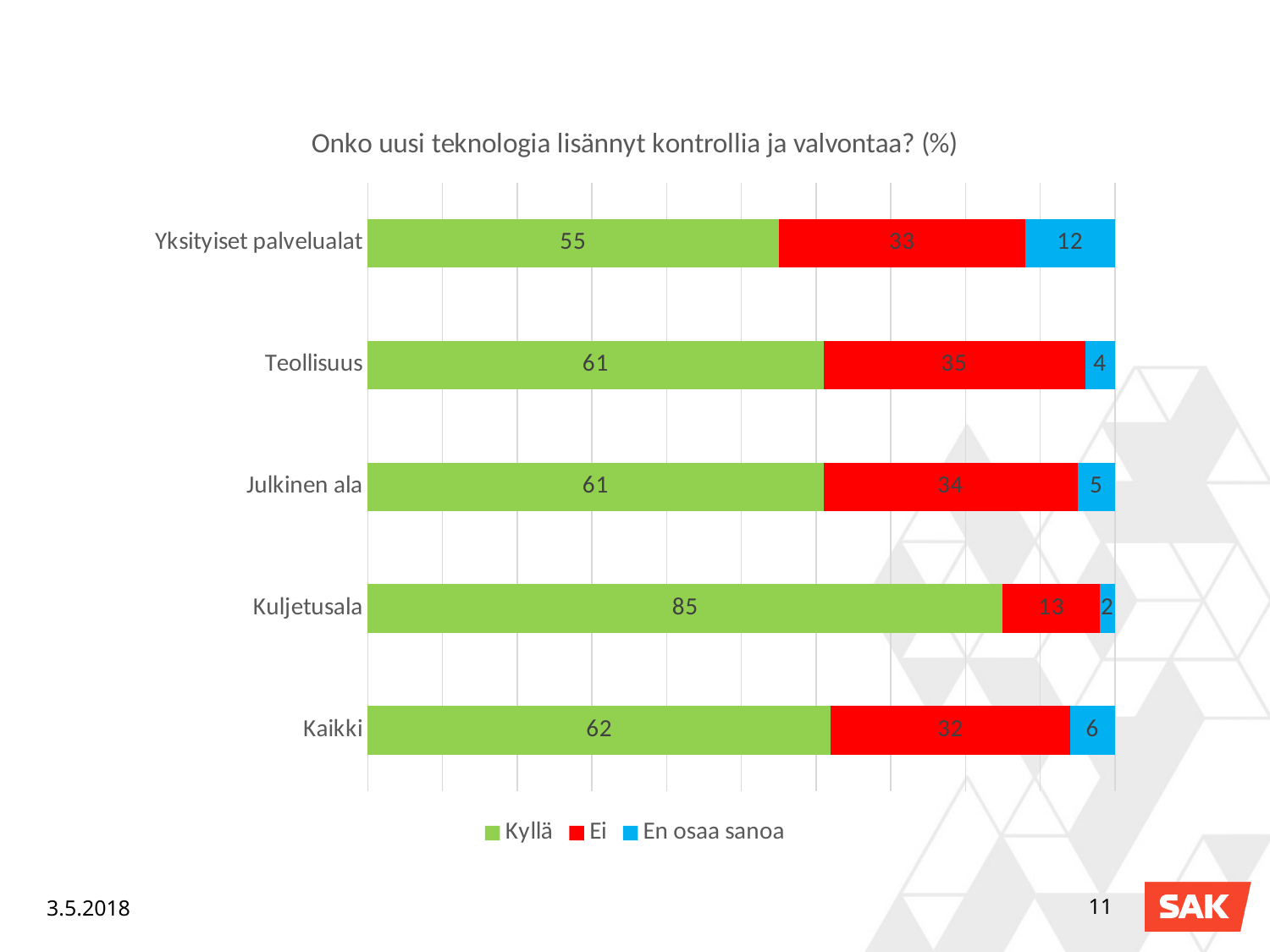
What is the total of the stacked bar for Julkinen ala? 100 What is the Ei value for Teollisuus? 35 How many categories are shown on the chart? 5 What is the difference between the Kyllä values for Kuljetusala and Kaikki? 23 What is the En osaa sanoa value for Yksityiset palvelualat? 12 Which category has the highest Kyllä value? Kuljetusala What is the Kyllä value for Kuljetusala? 85 Which is larger, the Ei value for Yksityiset palvelualat or the Ei value for Kuljetusala? Yksityiset palvelualat How many series does the legend list? 3 What kind of chart is shown on the slide? Stacked bar chart What is the title of the chart? Onko uusi teknologia lisännyt kontrollia ja valvontaa? (%) Which category has the lowest Kyllä value? Yksityiset palvelualat